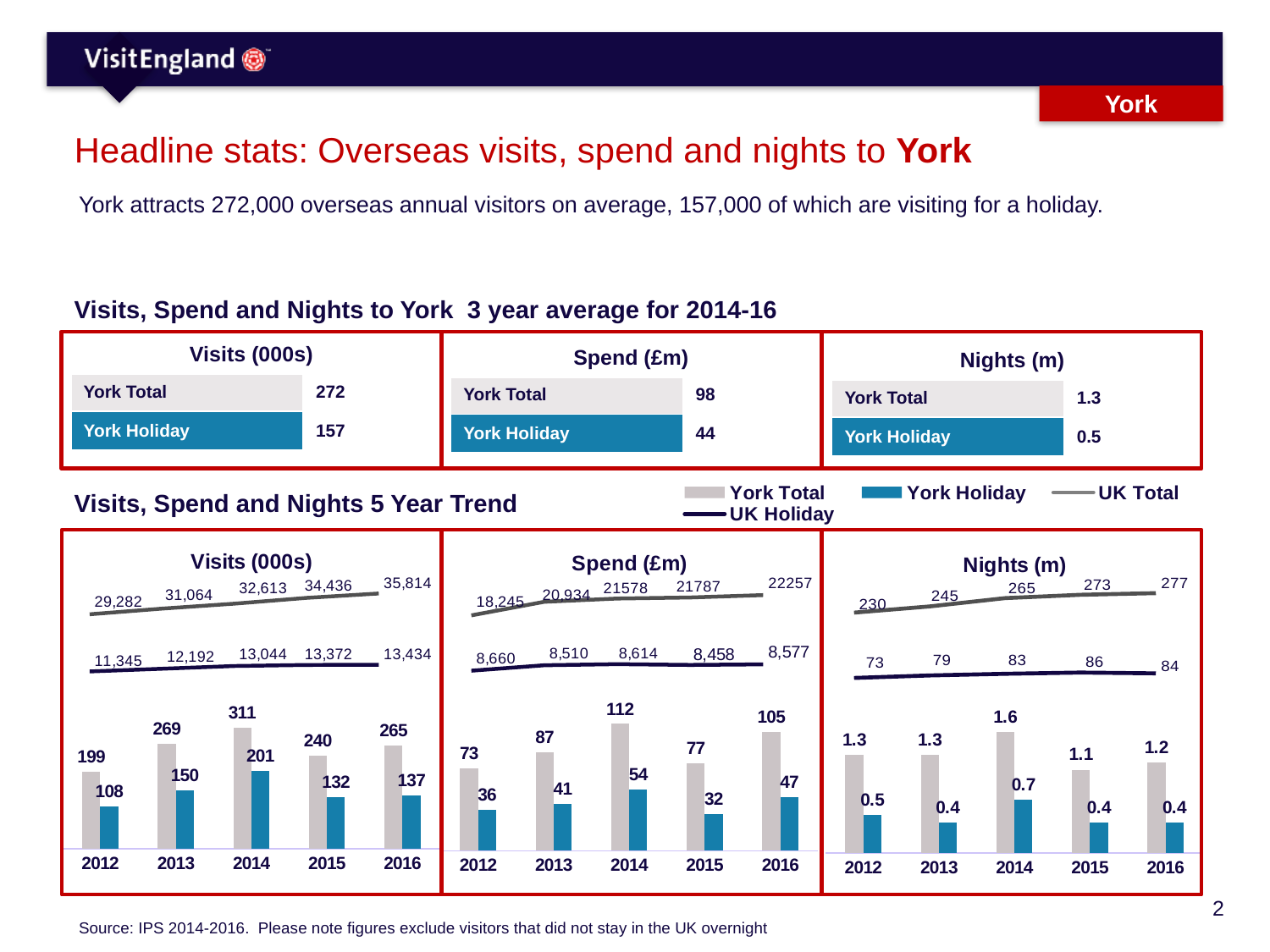
In the Visits (000s) trend chart, which year has the highest York Holiday value? 2014 In the Visits (000s) trend chart, what is the York Total value for 2014? 311 What kind of chart is used for the York Total and York Holiday series in the Visits (000s) trend chart? Bar chart In the Spend (£m) trend chart, what is the difference between York Total and York Holiday in 2016? 58 In the Visits (000s) trend chart, is the York Total value for 2013 larger than the York Total value for 2015? Yes, 2013 (269) is larger than 2015 (240) How many series does the legend for the 5 Year Trend charts list? 4 In the Visits (000s) trend chart, does the UK Total line rise or fall from 2012 to 2016? Rise In the Spend (£m) trend chart, what is the UK Holiday value for 2012? 8,660 In the Spend (£m) trend chart, what is the York Holiday value for 2015? 32 In the Nights (m) trend chart, which year has the lowest York Total value? 2015 How many years are shown on the x axis of the Spend (£m) trend chart? 5 In the Nights (m) trend chart, what is the UK Total value for 2016? 277